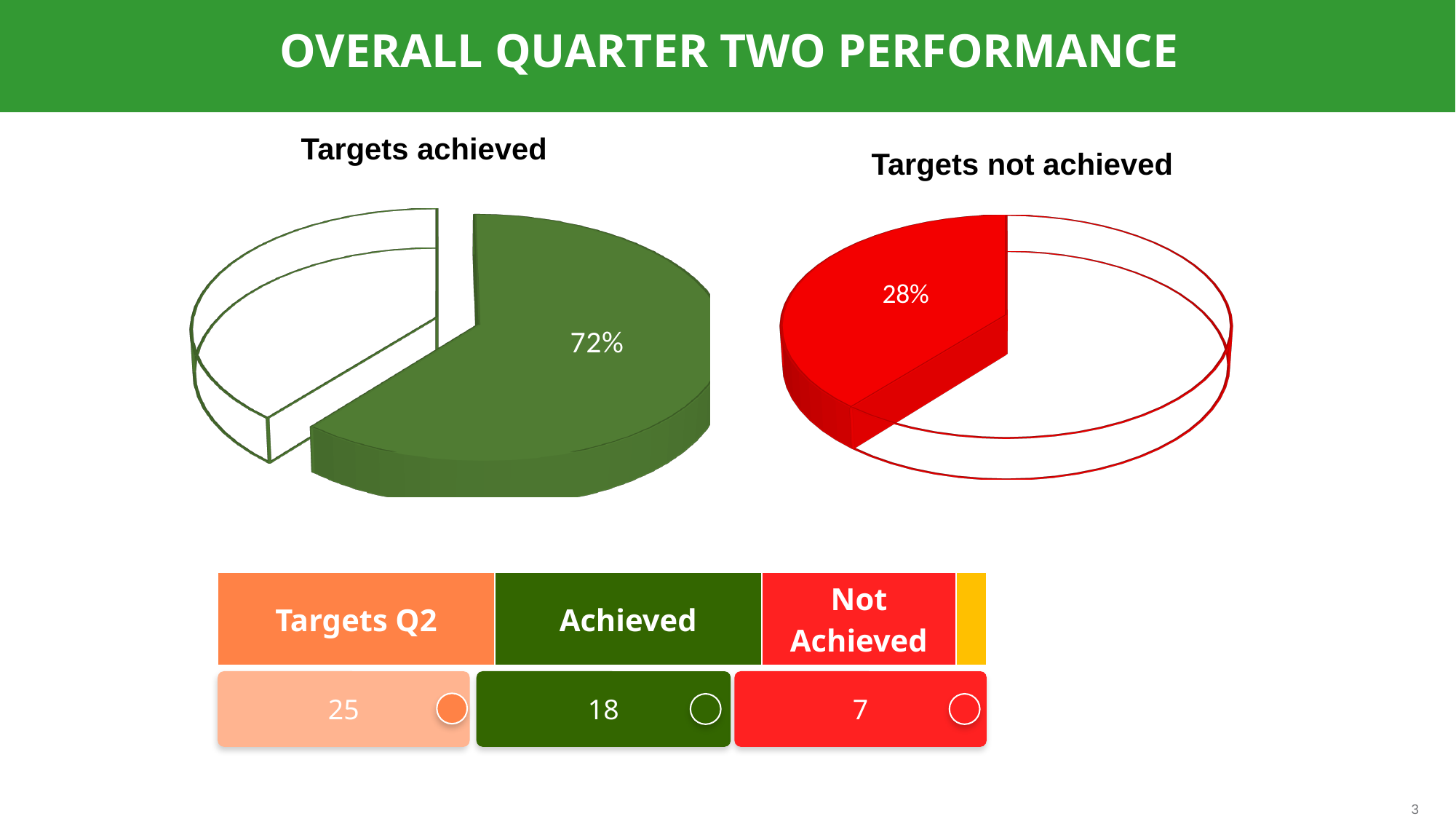
In the 'Targets not achieved' pie chart, is the filled slice greater or less than 50%? less What is the sum of the percentages labelled on the 'Targets achieved' and 'Targets not achieved' pie charts? 100% What kind of chart is the 'Targets not achieved' chart? Pie chart What colour is the filled slice in the 'Targets not achieved' pie chart? Red In the 'Targets achieved' pie chart, what percentage is shown on the filled slice? 72% Which is larger: the filled slice in the 'Targets achieved' chart or the filled slice in the 'Targets not achieved' chart? Targets achieved What colour is the filled slice in the 'Targets achieved' pie chart? Green How many pie charts are shown on the slide? 2 What kind of chart is the 'Targets achieved' chart? Pie chart In the 'Targets achieved' pie chart, is the filled slice greater or less than 50%? greater In the 'Targets not achieved' pie chart, what percentage is shown on the filled slice? 28% What is the difference between the percentage in the 'Targets achieved' chart and the percentage in the 'Targets not achieved' chart? 44 percentage points